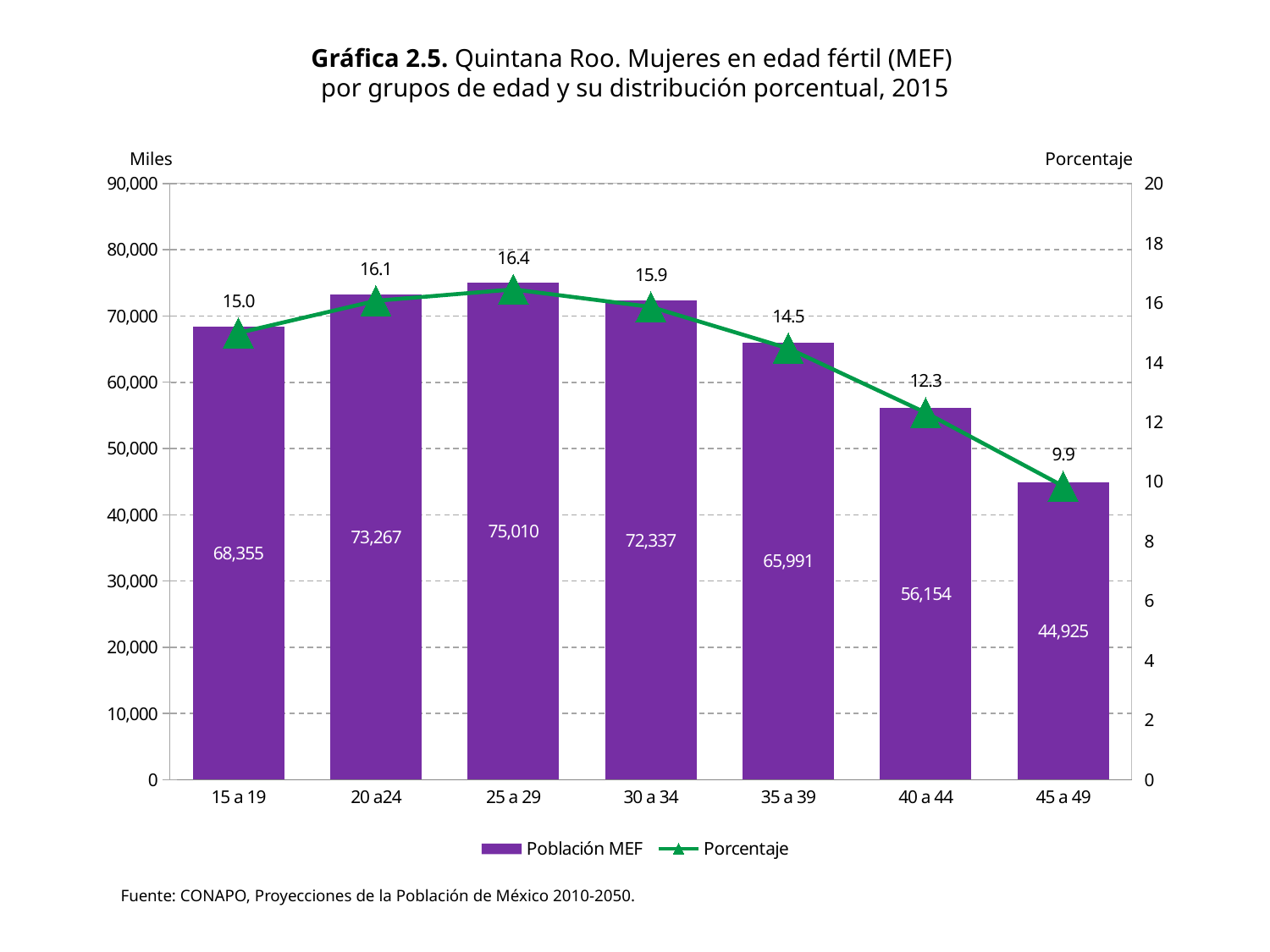
What is the difference in Porcentaje between the 25 a 29 and 35 a 39 age groups? 1.9 What is the Población MEF value for the 25 a 29 age group? 75,010 How many age groups are shown on the x axis? 7 Which age group has the lowest Porcentaje? 45 a 49 What kind of chart is used to show the Población MEF series? Bar chart How many series does the legend list? 2 What is the difference in Población MEF between the 20 a24 and 45 a 49 age groups? 28,342 How does the Porcentaje line change from the 25 a 29 group to the 45 a 49 group? It falls Which has a larger Población MEF, 15 a 19 or 30 a 34? 30 a 34 What is the Porcentaje value for the 40 a 44 age group? 12.3 Which age group has the highest Población MEF? 25 a 29 Is the Población MEF value for 35 a 39 greater or less than 60,000? greater